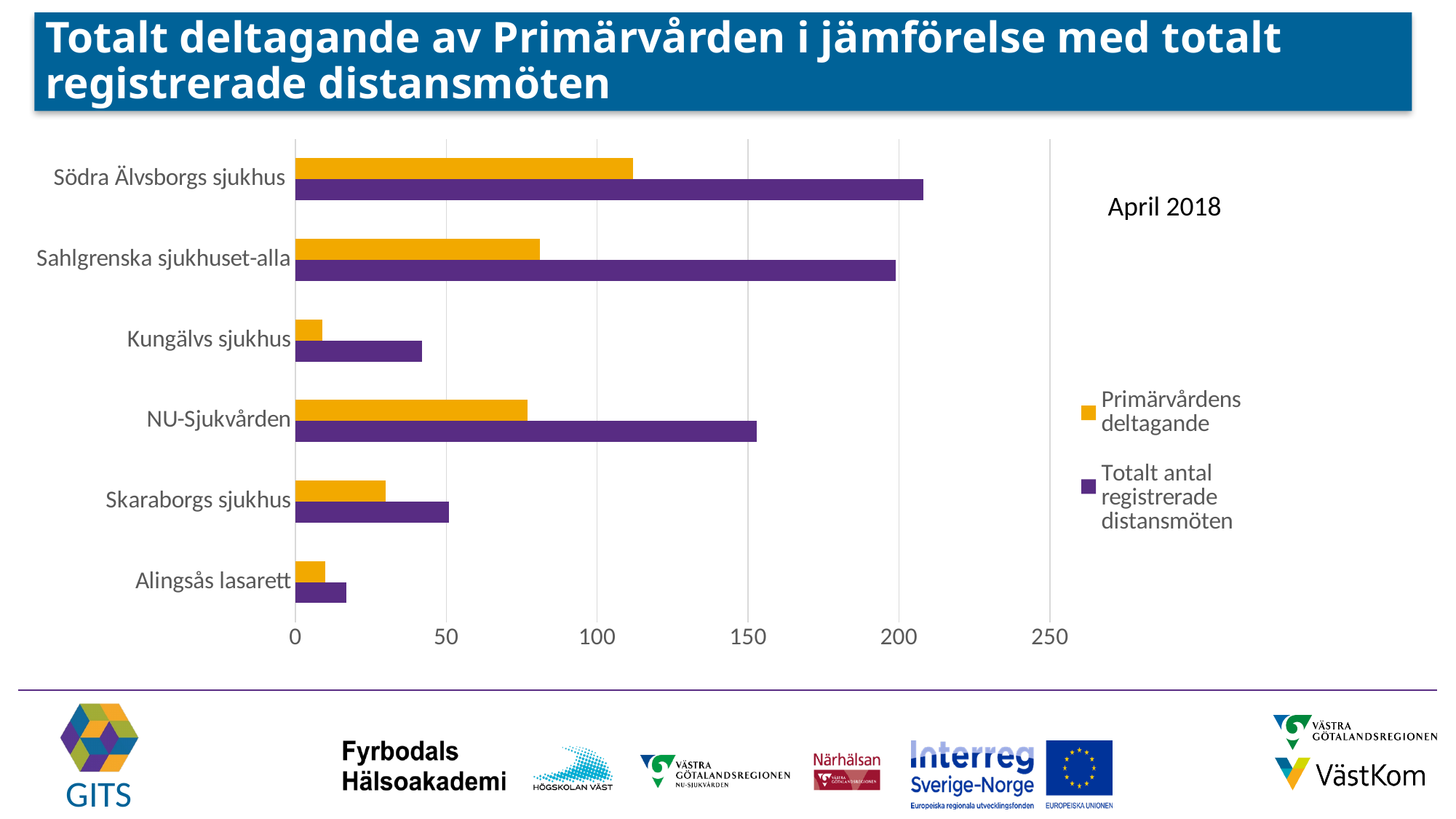
How many hospitals (categories) are shown on the chart? 6 Which colour represents Primärvårdens deltagande in the legend? yellow What kind of chart is shown on the slide? bar chart Is the value for Totalt antal registrerade distansmöten at Kungälvs sjukhus greater or less than 50? less Is the value for Primärvårdens deltagande at Sahlgrenska sjukhuset-alla greater or less than 100? less Which is larger: Totalt antal registrerade distansmöten for Sahlgrenska sjukhuset-alla or for NU-Sjukvården? Sahlgrenska sjukhuset-alla Which hospital has the highest value for Primärvårdens deltagande? Södra Älvsborgs sjukhus Which hospital has the lowest value for Totalt antal registrerade distansmöten? Alingsås lasarett Which month and year is shown as the period for the chart? April 2018 Is the value for Totalt antal registrerade distansmöten at Södra Älvsborgs sjukhus greater or less than 200? greater How many series does the legend list? 2